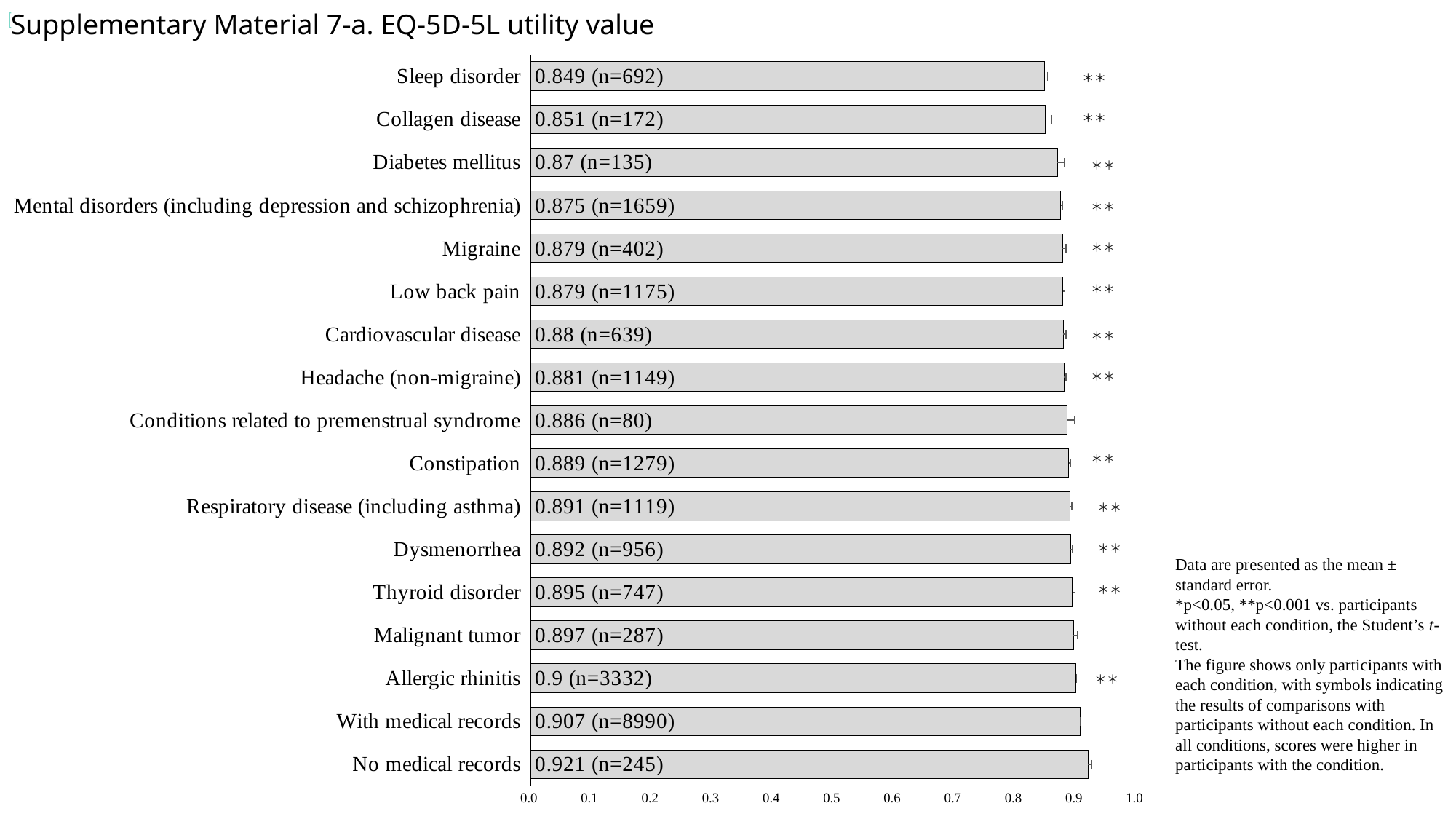
How many categories (bars) are shown in the chart? 17 What is the largest sample size (n) shown among the categories? 8990 Which category has the lowest utility value? Sleep disorder Which category has the highest utility value? No medical records What is the utility value shown for Allergic rhinitis? 0.9 Is the utility value for Collagen disease greater or less than 0.9? less How many participants (n) are in the Mental disorders (including depression and schizophrenia) group? 1659 What kind of chart is shown on the slide? bar chart Which has a higher utility value, Diabetes mellitus or Thyroid disorder? Thyroid disorder What is the utility value for Thyroid disorder? 0.895 What is the EQ-5D-5L utility value for Sleep disorder? 0.849 What is the difference between the utility values for No medical records and Sleep disorder? 0.072